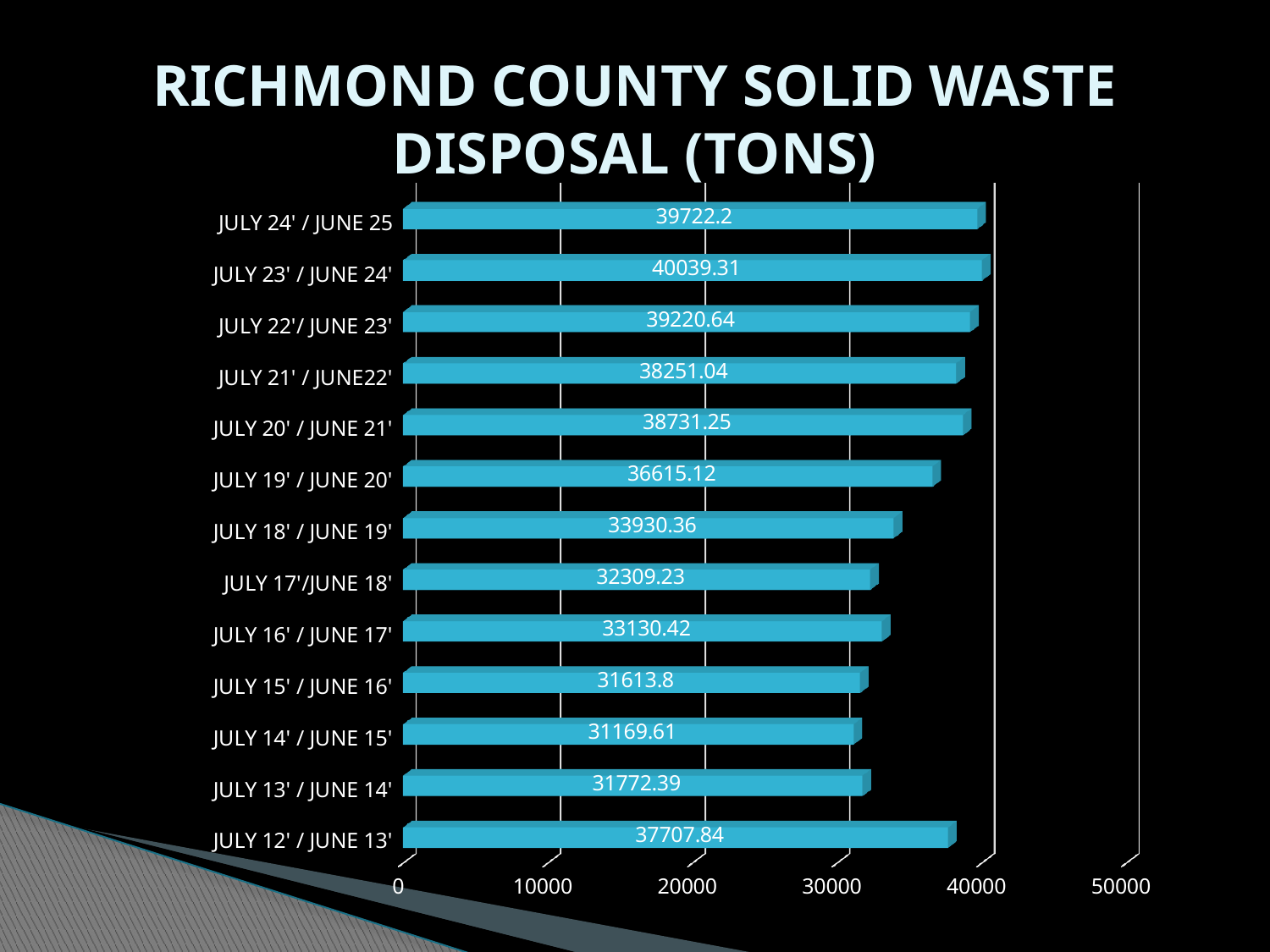
What is the difference between the values for JULY 12' / JUNE 13' and JULY 13' / JUNE 14'? 5935.45 What is the difference between the values for JULY 23' / JUNE 24' and JULY 24' / JUNE 25? 317.11 What is the value for JULY 23' / JUNE 24'? 40039.31 How many periods are shown in the chart? 13 Which period has the highest solid waste disposal? JULY 23' / JUNE 24' What is the value for JULY 12' / JUNE 13'? 37707.84 What is the value for JULY 15' / JUNE 16'? 31613.8 Is the value for JULY 19' / JUNE 20' greater or less than 30000? greater Which is larger, the value for JULY 16' / JUNE 17' or JULY 17' / JUNE 18'? JULY 16' / JUNE 17' What is the title of the chart? RICHMOND COUNTY SOLID WASTE DISPOSAL (TONS) What kind of chart is shown on the slide? bar chart Which period has the lowest solid waste disposal? JULY 14' / JUNE 15'